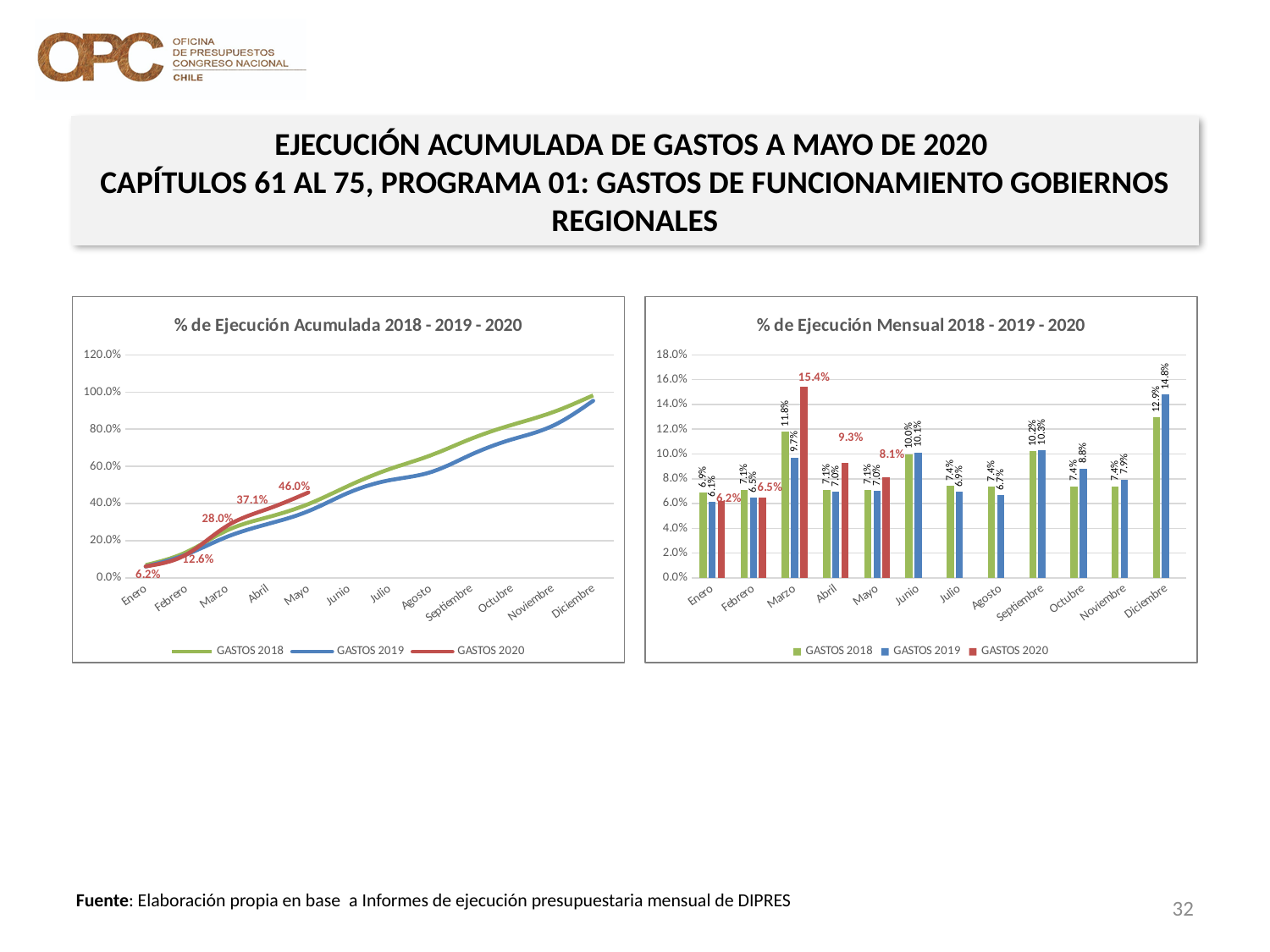
In the left chart '% de Ejecución Acumulada', by how much does the GASTOS 2020 value increase from Marzo to Abril? 9.1% In the right chart '% de Ejecución Mensual', what is the GASTOS 2019 value for Diciembre? 14.8% What type of chart is the left chart titled '% de Ejecución Acumulada 2018 - 2019 - 2020'? Line chart What type of chart is the right chart titled '% de Ejecución Mensual 2018 - 2019 - 2020'? Bar chart In the left chart '% de Ejecución Acumulada', what is the GASTOS 2020 value for Mayo? 46.0% In the right chart '% de Ejecución Mensual', how many series does the legend list? 3 In the left chart '% de Ejecución Acumulada', what is the GASTOS 2020 value for Marzo? 28.0% In the right chart '% de Ejecución Mensual', what is the GASTOS 2020 value for Marzo? 15.4% In the right chart '% de Ejecución Mensual', which month has the highest GASTOS 2020 value? Marzo In the left chart '% de Ejecución Acumulada', how many months are shown on the x axis? 12 In the left chart '% de Ejecución Acumulada', does the GASTOS 2020 line rise or fall from Enero to Mayo? Rises In the right chart '% de Ejecución Mensual', which is larger in Marzo: GASTOS 2018 or GASTOS 2019? GASTOS 2018